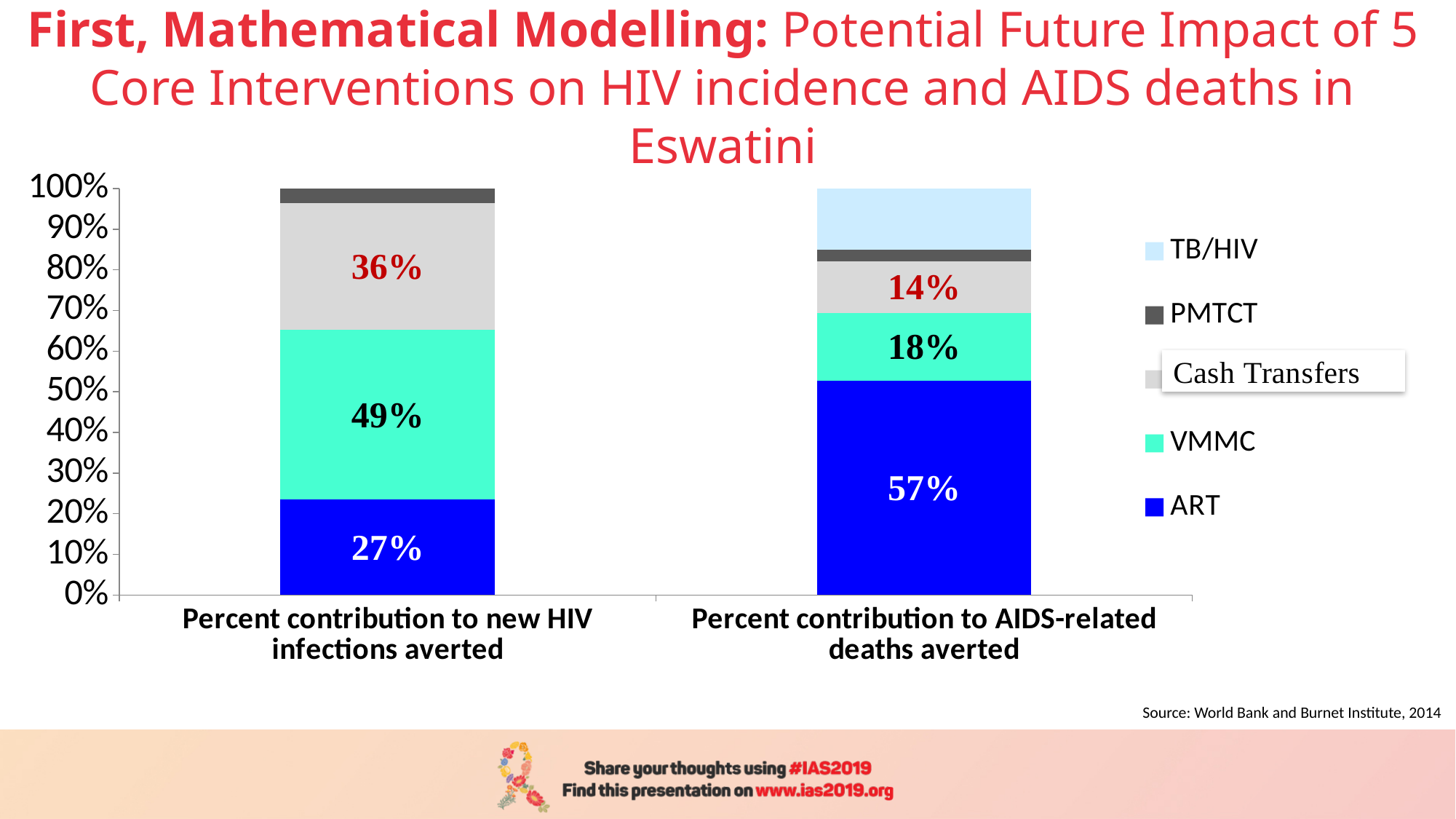
What is the data label for Cash Transfers in the 'Percent contribution to new HIV infections averted' bar? 36% Is the PMTCT segment in the 'Percent contribution to new HIV infections averted' bar greater or less than 10%? less What is the difference between the ART labels for AIDS-related deaths averted (57%) and new HIV infections averted (27%)? 30% Is the Cash Transfers value larger for new HIV infections averted or for AIDS-related deaths averted? New HIV infections averted What is the data label for ART in the 'Percent contribution to new HIV infections averted' bar? 27% Which labelled series has the largest value in the 'Percent contribution to AIDS-related deaths averted' bar? ART How many categories are shown on the x axis? 2 How many series does the legend list? 5 What is the data label for VMMC in the 'Percent contribution to AIDS-related deaths averted' bar? 18% What kind of chart is shown on the slide? Stacked bar chart Which labelled series has the largest value in the 'Percent contribution to new HIV infections averted' bar? VMMC What is the data label for ART in the 'Percent contribution to AIDS-related deaths averted' bar? 57%